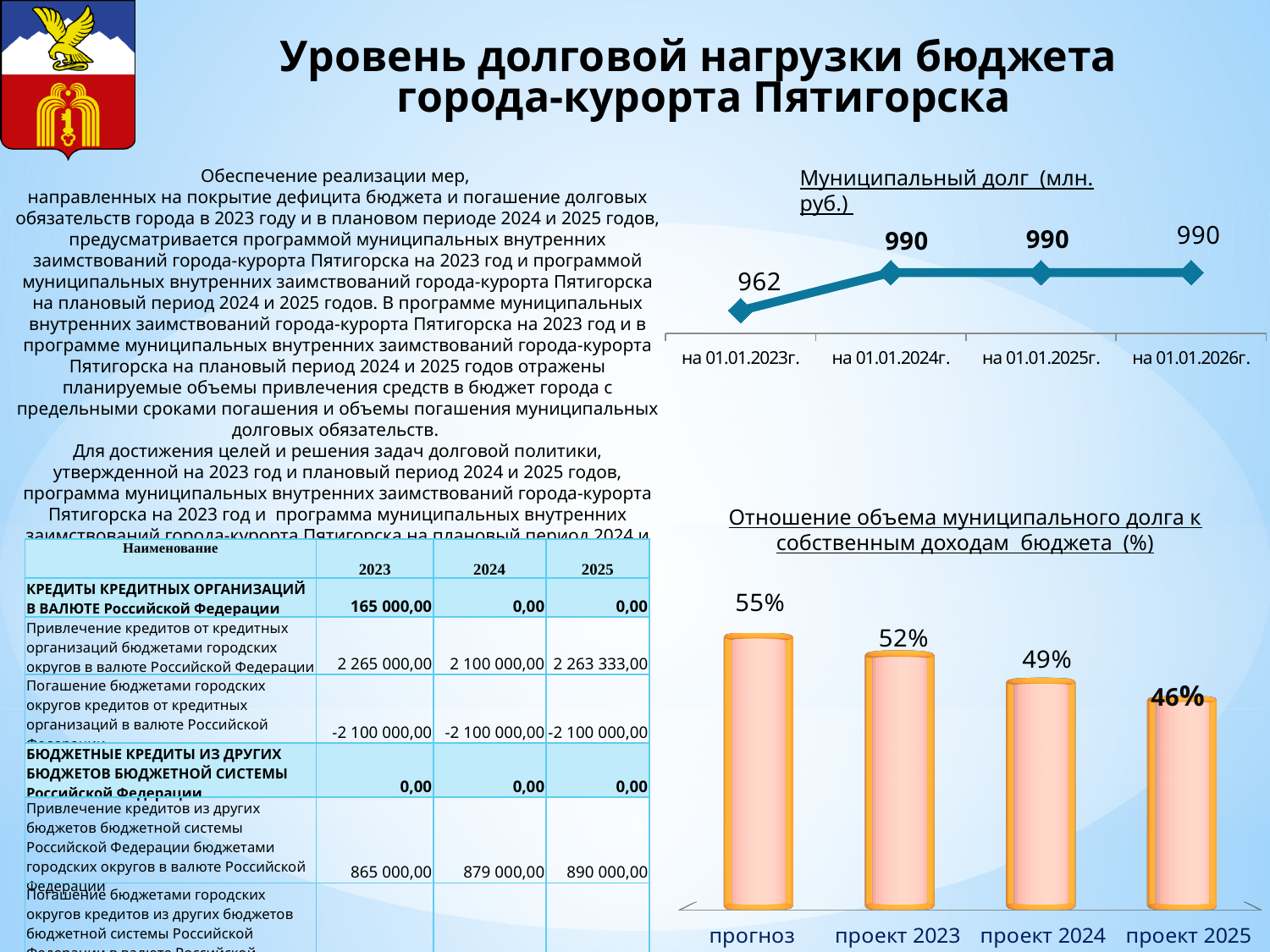
In the chart titled 'Отношение объема муниципального долга к собственным доходам бюджета (%)', what is the difference between the values for прогноз and проект 2025? 9% In the chart titled 'Муниципальный долг (млн. руб.)', how many data points are plotted? 4 In the chart titled 'Муниципальный долг (млн. руб.)', what is the value for на 01.01.2023г.? 962 In the chart titled 'Муниципальный долг (млн. руб.)', which date has the lowest value? на 01.01.2023г. In the chart titled 'Отношение объема муниципального долга к собственным доходам бюджета (%)', which category has the highest value? прогноз In the chart titled 'Муниципальный долг (млн. руб.)', what is the value for на 01.01.2025г.? 990 In the chart titled 'Отношение объема муниципального долга к собственным доходам бюджета (%)', what is the value for проект 2024? 49% In the chart titled 'Муниципальный долг (млн. руб.)', what is the difference between the values for на 01.01.2024г. and на 01.01.2023г.? 28 In the chart titled 'Отношение объема муниципального долга к собственным доходам бюджета (%)', which category has the lowest value? проект 2025 In the chart titled 'Отношение объема муниципального долга к собственным доходам бюджета (%)', what is the value for прогноз? 55% In the chart titled 'Отношение объема муниципального долга к собственным доходам бюджета (%)', do the values rise or fall from left to right? fall What kind of chart is the one titled 'Муниципальный долг (млн. руб.)'? line chart